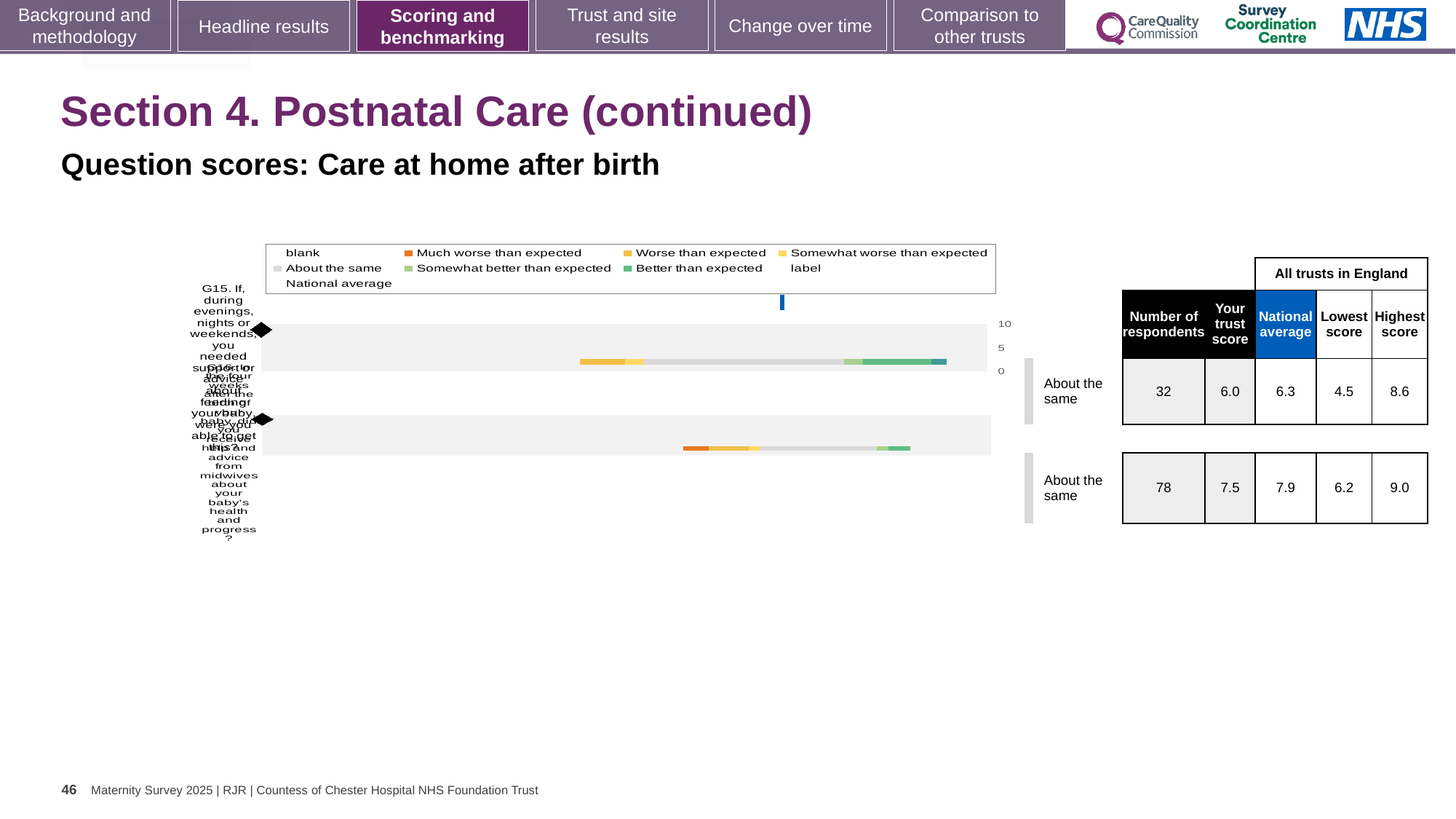
For the top row, what is the difference between the highest and lowest scores? 4.1 How many question rows are plotted in the chart? 2 For the bottom row, what is the difference between the national average and the trust score? 0.4 What benchmark category is shown for both rows of the chart? About the same Which row has the higher trust score, the top row or the bottom row? Bottom row How many entries does the chart legend list? 9 What is the trust score for the bottom row of the chart? 7.5 What is the number of respondents for the top row of the chart? 32 What is the national average for the top row of the chart? 6.3 What kind of chart is shown on the slide? Bar chart What is the lowest score among all trusts in England for the bottom row? 6.2 What is the highest score among all trusts in England for the top row? 8.6